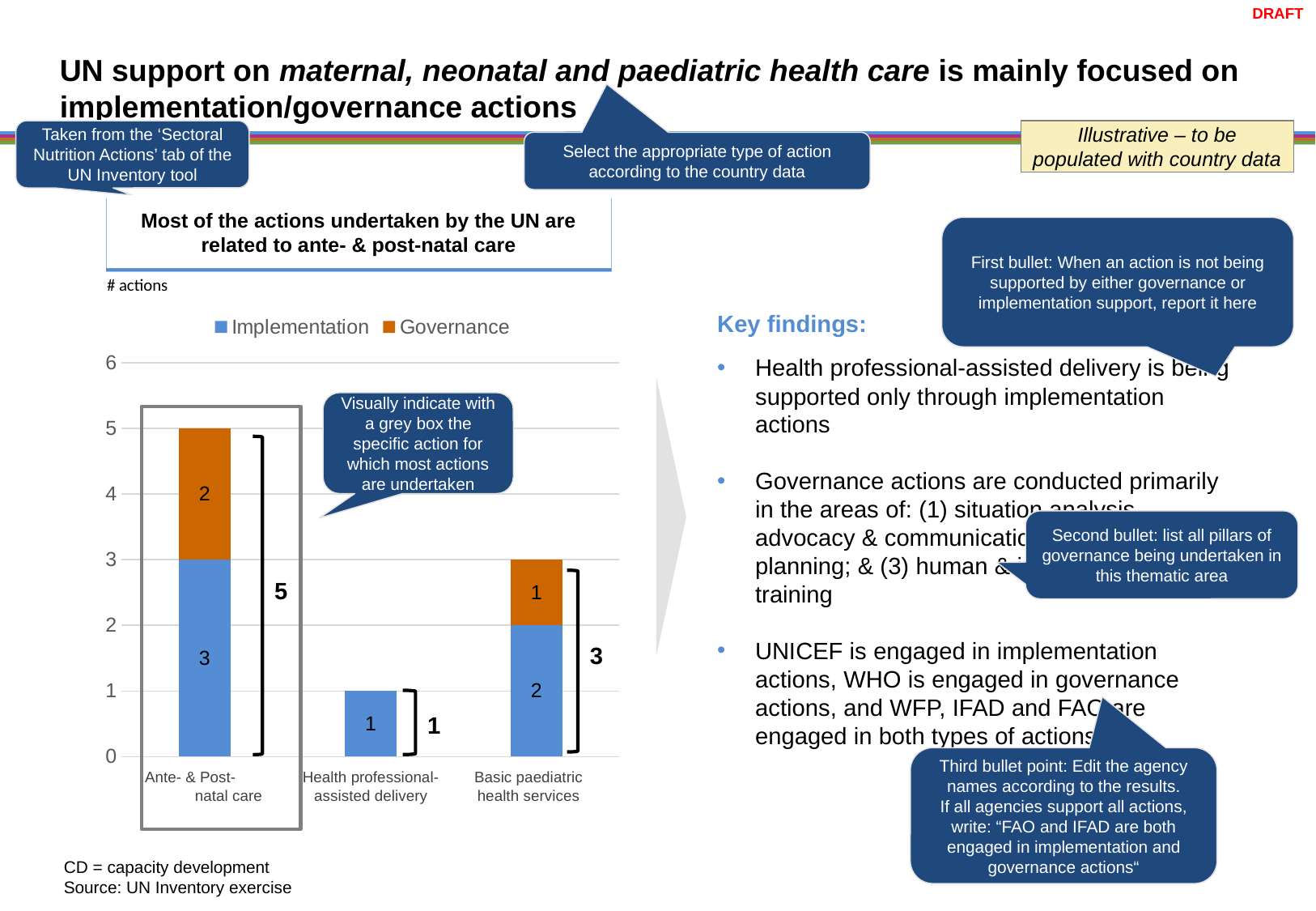
What is the Governance value for Ante- & Post-natal care? 2 What is the difference between the total actions for Ante- & Post-natal care and Basic paediatric health services? 2 How many series does the chart legend list? 2 What is the Governance value for Basic paediatric health services? 1 What is the Implementation value for Ante- & Post-natal care? 3 Which category has the lowest total number of actions? Health professional-assisted delivery Which is larger: the Implementation value for Ante- & Post-natal care or the Implementation value for Basic paediatric health services? Ante- & Post-natal care What is the Implementation value for Health professional-assisted delivery? 1 What is the total number of actions for Basic paediatric health services? 3 What is the total number of actions for Ante- & Post-natal care? 5 How many categories are shown on the x axis of the chart? 3 Which category has the highest total number of actions? Ante- & Post-natal care